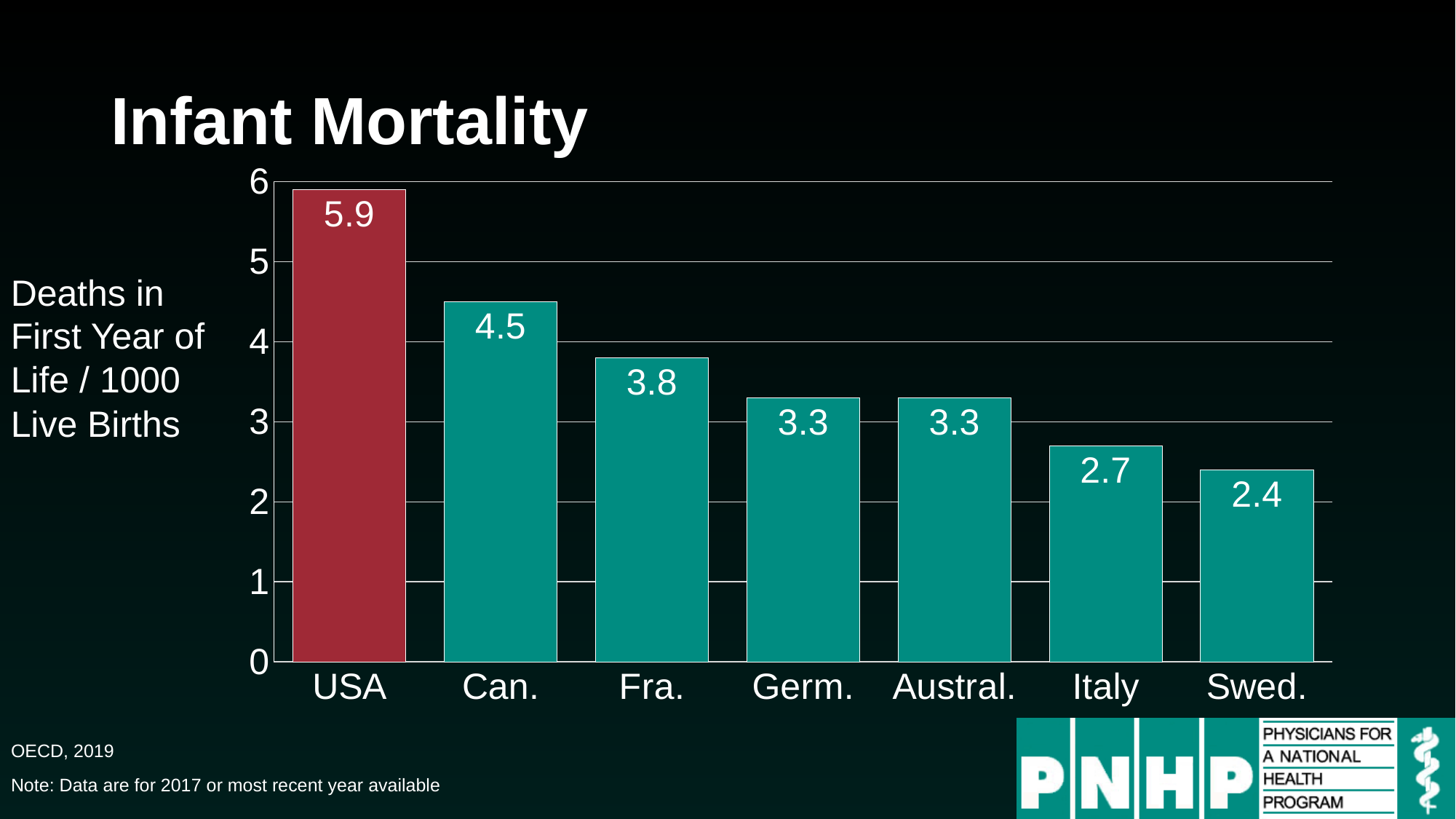
What is the infant mortality value shown for Fra.? 3.8 What is the infant mortality value shown for the USA? 5.9 What is the difference between the USA value and the Can. value? 1.4 Which has a higher infant mortality value, Can. or Italy? Can. Which country has the lowest infant mortality on the chart? Swed. Which bar is coloured differently from the others? USA What is the difference between the Fra. value and the Swed. value? 1.4 What is the infant mortality value shown for Italy? 2.7 What kind of chart is shown on the slide? bar chart Is the value for Germ. greater or less than 4? less How many countries are shown on the chart? 7 Which country has the highest infant mortality on the chart? USA